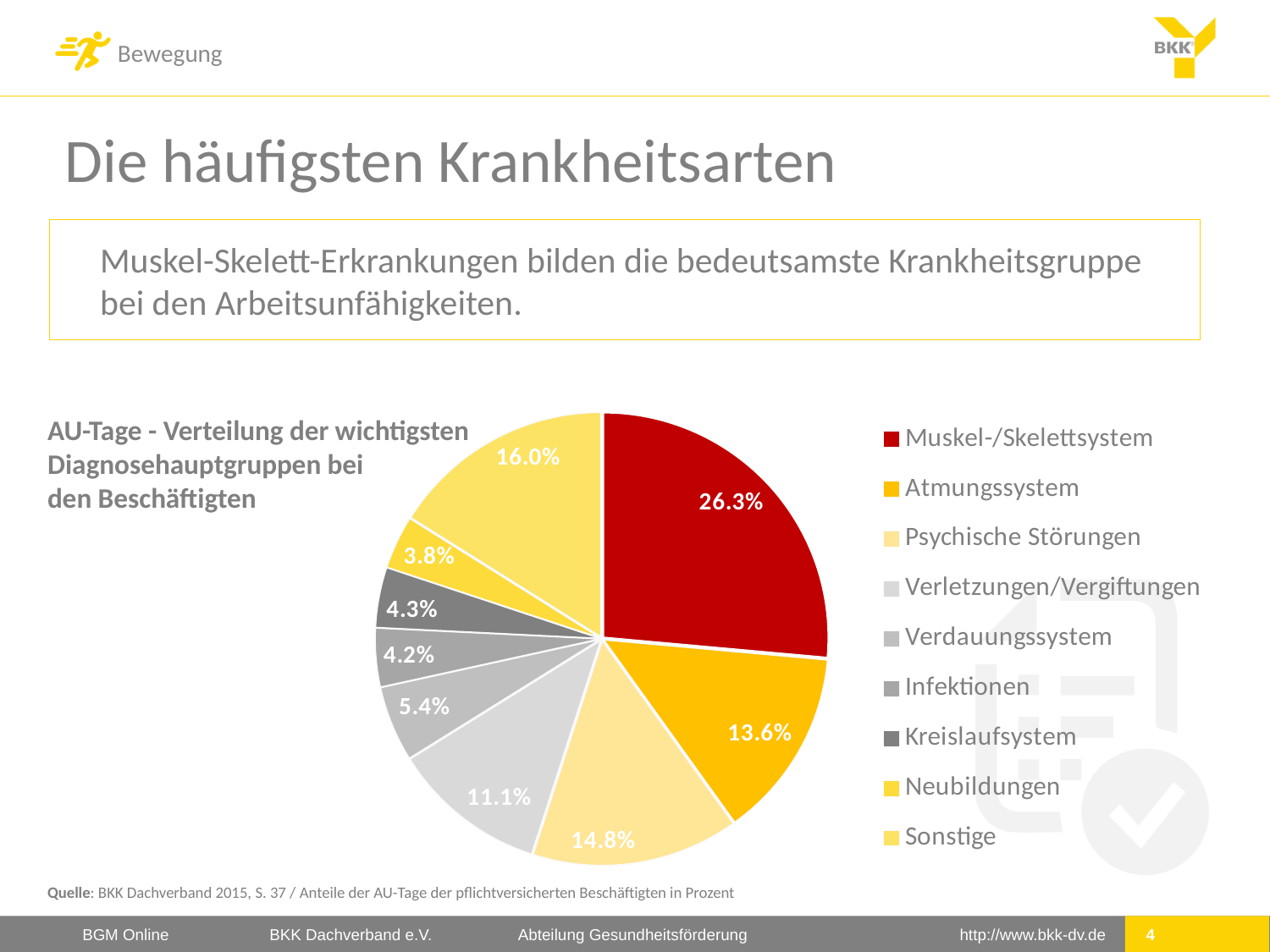
What share of AU-Tage does Muskel-/Skelettsystem account for? 26.3% Which diagnosis group has the largest share of the pie? Muskel-/Skelettsystem What is the value for Verletzungen/Vergiftungen? 11.1% What type of chart is shown on the slide? Pie chart Which has a larger share, Psychische Störungen or Atmungssystem? Psychische Störungen What percentage is shown for Sonstige? 16.0% What colour is the slice for Muskel-/Skelettsystem? Red How many slices does the pie chart have? 9 Which diagnosis group has the smallest share of the pie? Neubildungen What is the difference between the shares of Muskel-/Skelettsystem and Atmungssystem? 12.7% What is the value shown for Psychische Störungen? 14.8% How many entries does the legend list? 9